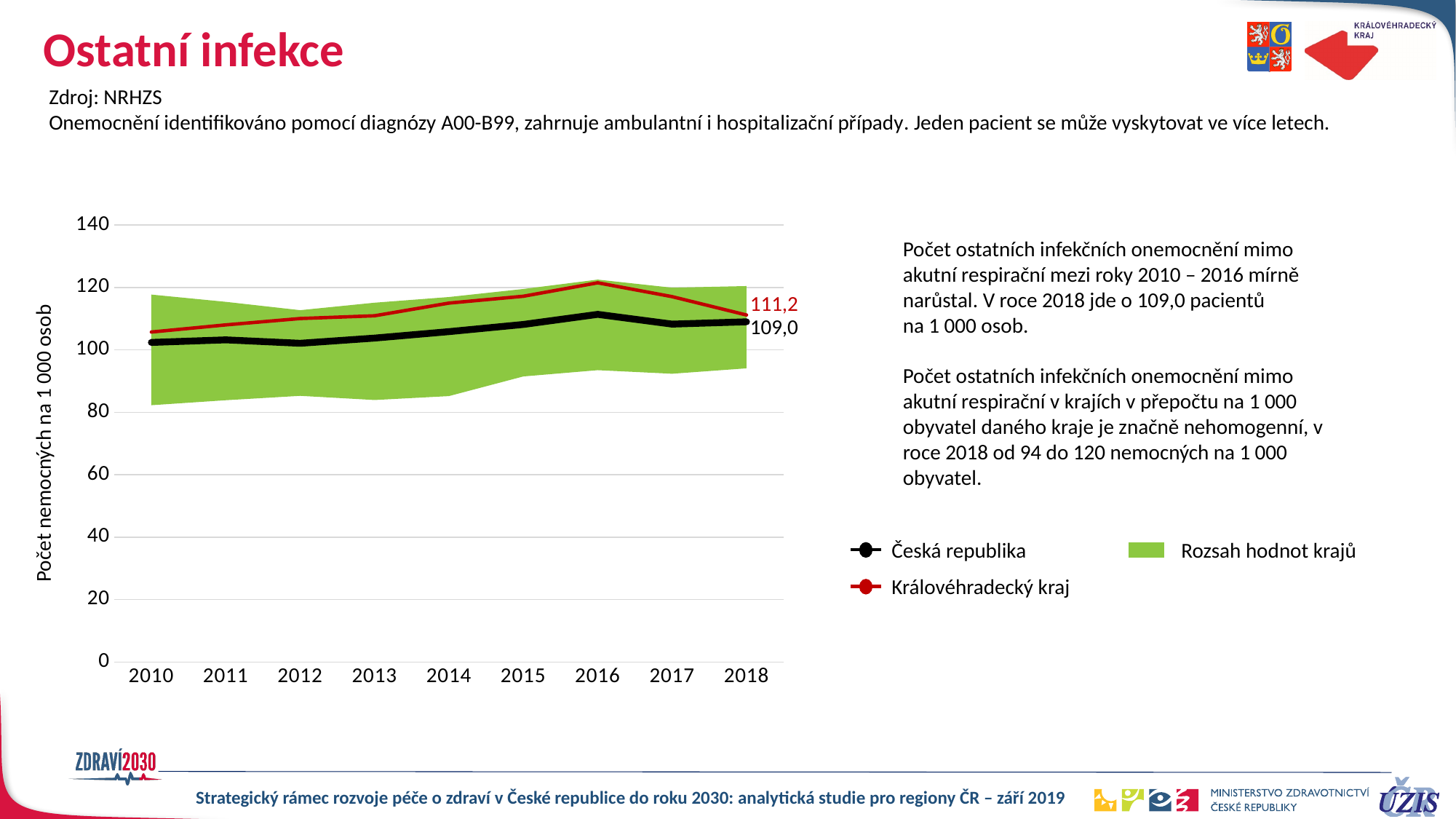
Is the value for Česká republika in 2010 greater or less than 120? less What is the value for Královéhradecký kraj in 2018? 111,2 What kind of chart is shown on the slide? combination area and line chart What is the value for Česká republika in 2018? 109,0 How many years are shown on the x axis? 9 In 2018, which is larger: the value for Královéhradecký kraj or for Česká republika? Královéhradecký kraj Does the Česká republika line rise or fall between 2010 and 2016? rise Is the value for Královéhradecký kraj in 2016 greater or less than 100? greater What colour is the line for Královéhradecký kraj? red How many entries does the legend list? 3 What is the difference between the 2018 values for Královéhradecký kraj and Česká republika? 2,2 In which year does the Královéhradecký kraj line reach its highest value? 2016